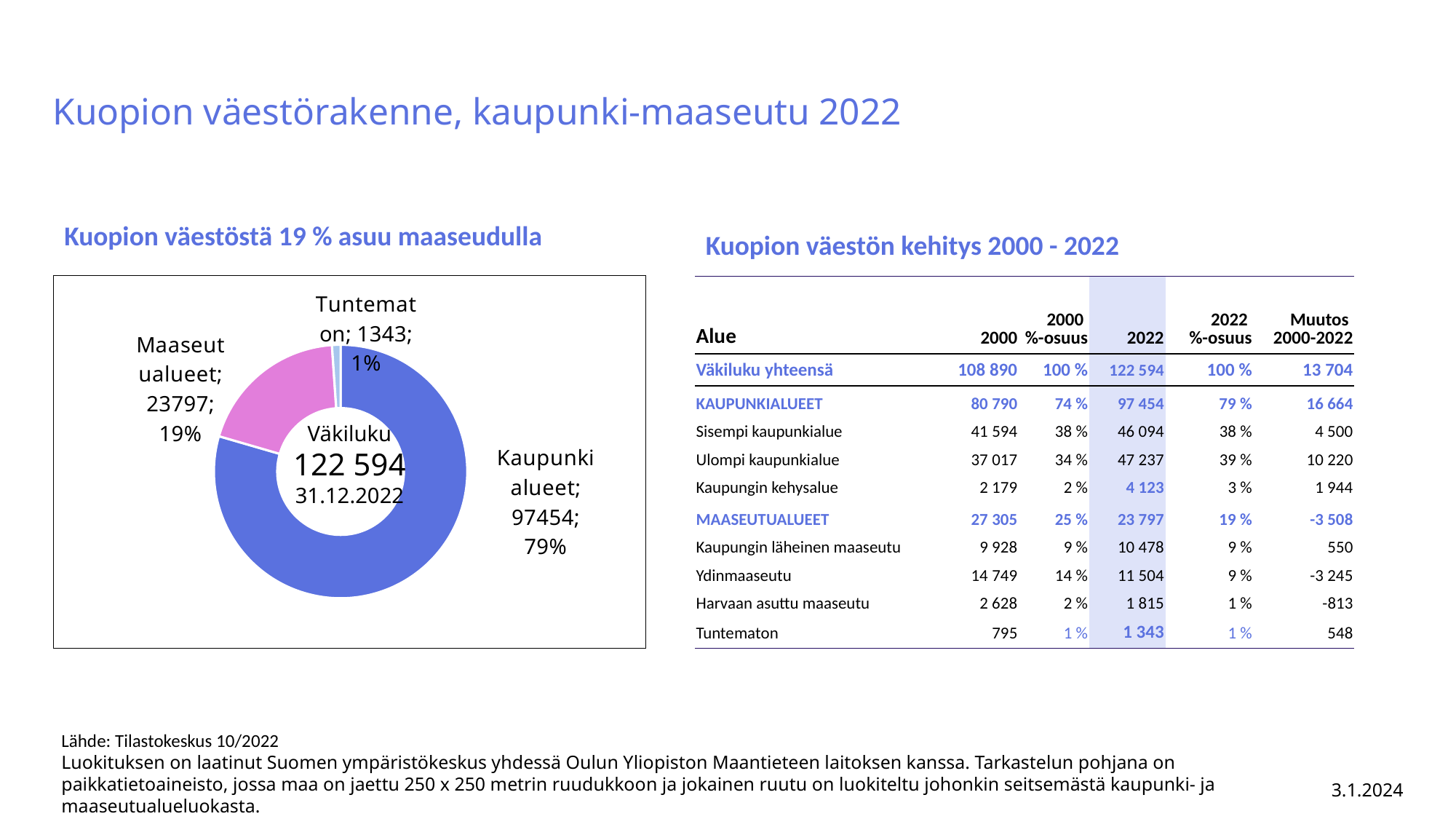
What share of the pie does Maaseutualueet represent? 19% What total population (Väkiluku) is shown in the centre of the pie chart? 122 594 What is the value shown for Maaseutualueet in the pie chart? 23797 How many slices does the pie chart have? 3 What is the value shown for Tuntematon in the pie chart? 1343 What kind of chart is shown on the slide? Pie chart (donut) Which slice of the pie chart is the smallest? Tuntematon What is the difference between the values for Kaupunkialueet and Maaseutualueet in the pie chart? 73657 What share of the pie does Tuntematon represent? 1% What is the value shown for Kaupunkialueet in the pie chart? 97454 What share of the pie does Kaupunkialueet represent? 79% Which slice of the pie chart is the largest? Kaupunkialueet